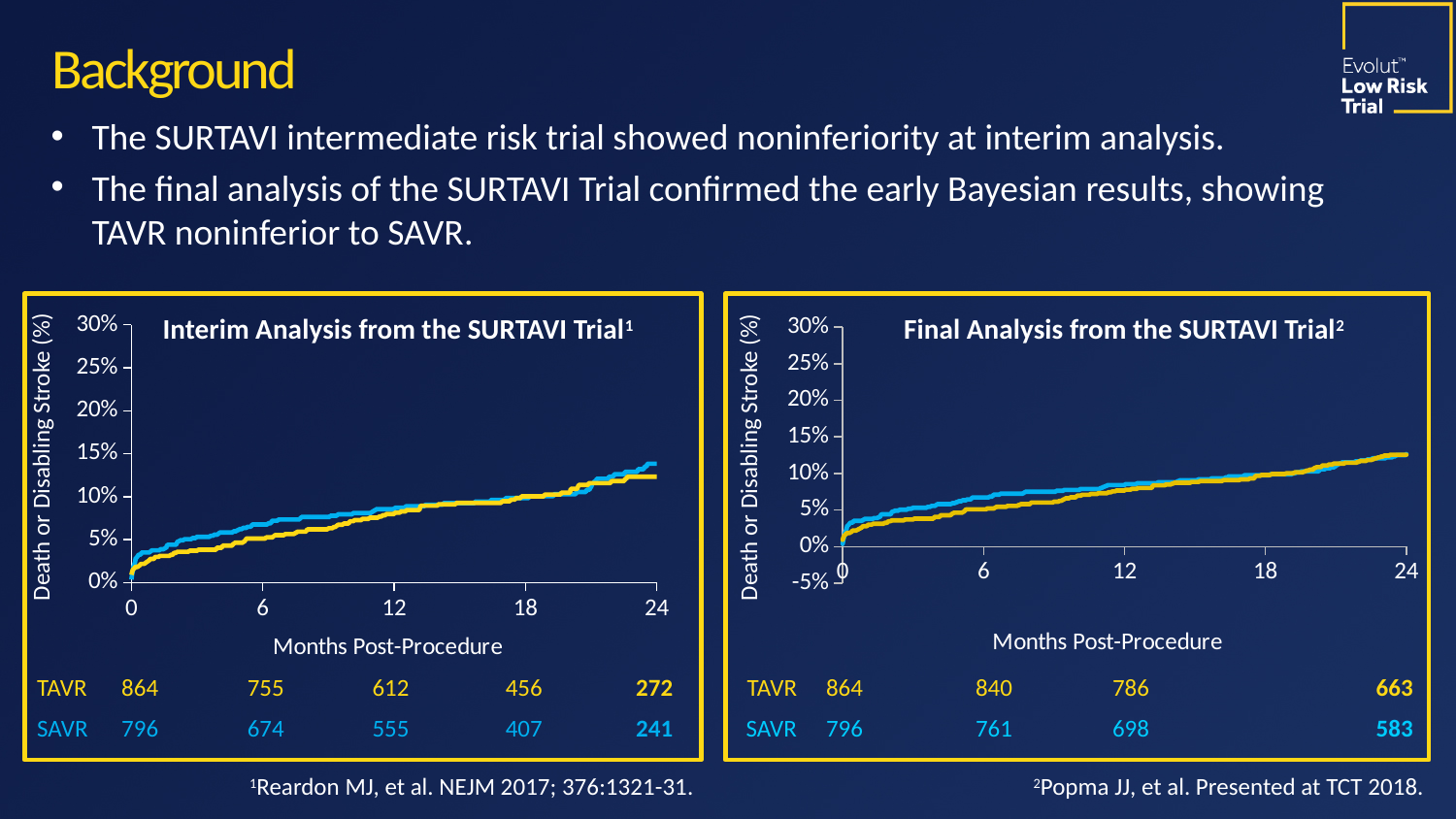
How many series are plotted in the Final Analysis from the SURTAVI Trial chart? 2 In the Interim Analysis from the SURTAVI Trial chart, how many TAVR patients are at risk at 24 months? 272 In the Final Analysis from the SURTAVI Trial chart, is the value for SAVR at 24 months greater or less than 15%? less In the Interim Analysis from the SURTAVI Trial chart, do the curves rise or fall as months post-procedure increase? rise In the Interim Analysis from the SURTAVI Trial chart, how many SAVR patients are at risk at 12 months? 555 In the Final Analysis from the SURTAVI Trial chart, is the value for TAVR at 6 months greater or less than 10%? less In the Final Analysis from the SURTAVI Trial chart, what is the difference between the TAVR and SAVR numbers at risk at 24 months? 80 In the Final Analysis from the SURTAVI Trial chart, how many SAVR patients are at risk at 24 months? 583 What is the y-axis label of the Interim Analysis from the SURTAVI Trial chart? Death or Disabling Stroke (%) In the Final Analysis from the SURTAVI Trial chart, do the curves rise or fall along the x axis? rise In the Interim Analysis from the SURTAVI Trial chart, is the value for TAVR at 24 months greater or less than 10%? greater What kind of chart is the Interim Analysis from the SURTAVI Trial chart? line chart